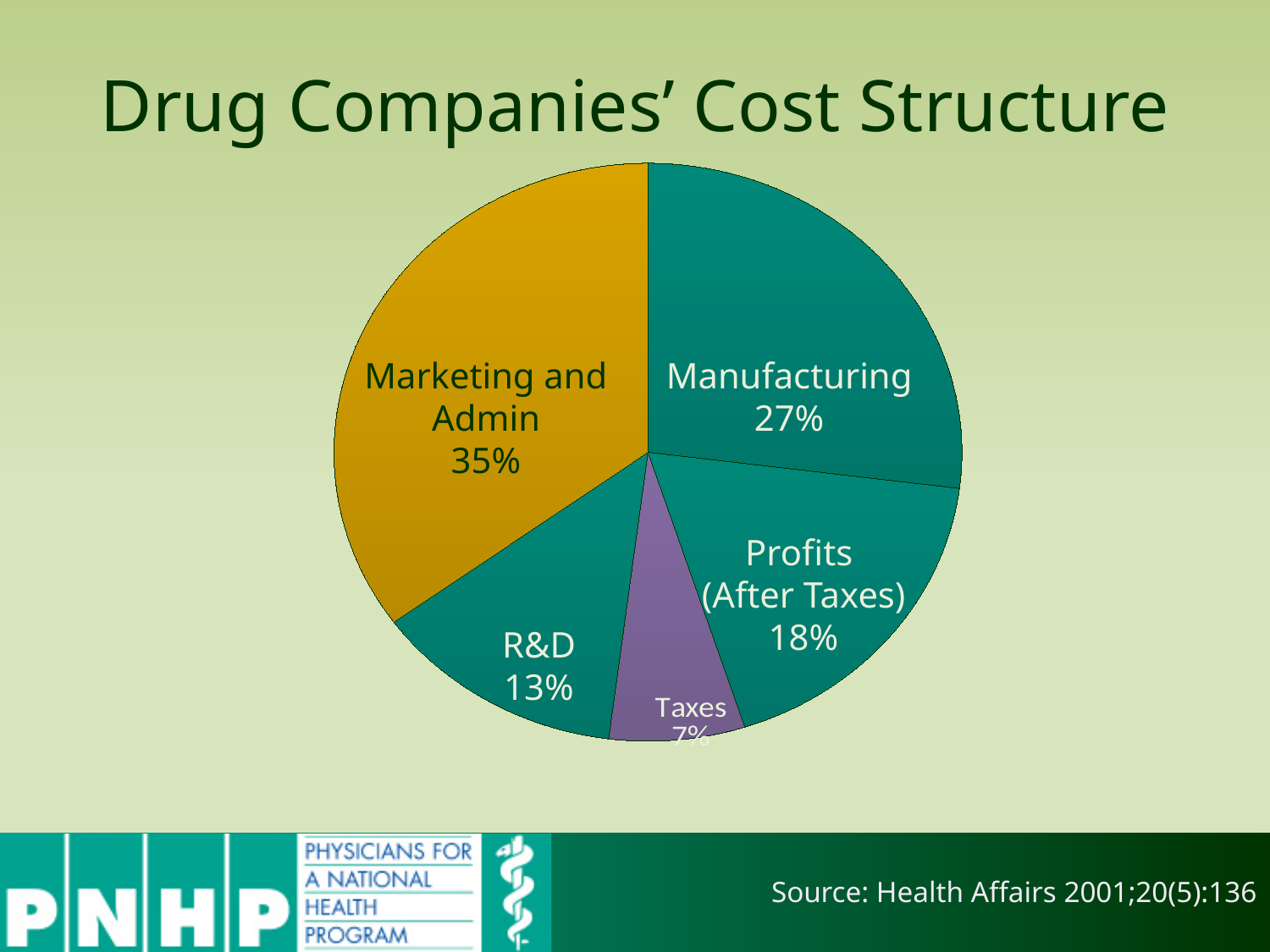
How many percentage points larger is Marketing and Admin than Manufacturing? 8 percentage points What percentage of the cost structure is Profits (After Taxes)? 18% What percentage of the cost structure is R&D? 13% What kind of chart is shown on the slide? Pie chart What is the title of the chart? Drug Companies' Cost Structure Which is larger, Manufacturing or Profits (After Taxes)? Manufacturing Which category has the largest share of the pie? Marketing and Admin What percentage of the cost structure is Manufacturing? 27% How many percentage points larger is Profits (After Taxes) than R&D? 5 percentage points How many slices does the pie chart have? 5 What percentage of the cost structure is Marketing and Admin? 35% Which category has the smallest share of the pie? Taxes